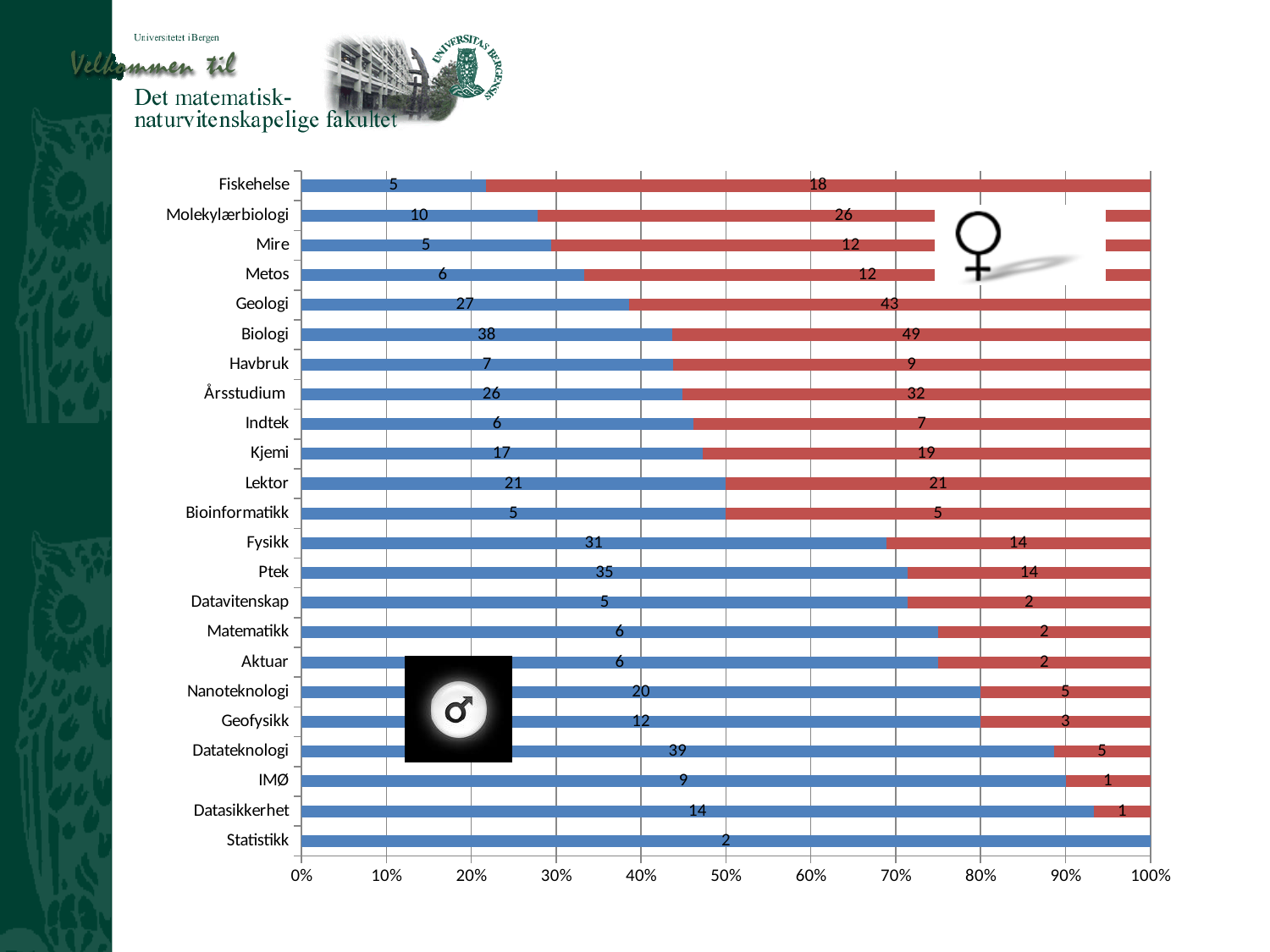
Is the blue value for Ptek larger or smaller than the blue value for Fysikk? larger How many categories (study programmes) are listed on the vertical axis of the chart? 23 Is the blue share of the bar for Fiskehelse greater or less than 30%? less What is the value shown on the blue bar for Biologi? 38 What kind of chart is shown on the slide? Stacked bar chart What is the value shown on the blue bar for Datateknologi? 39 Which category has the highest value on its blue bar? Datateknologi What is the value shown on the red bar for Fiskehelse? 18 What is the total of the blue and red values for Biologi? 87 What is the value shown on the red bar for Geologi? 43 What is the difference between the blue value and the red value for Fysikk? 17 Which category has the highest value on its red bar? Biologi